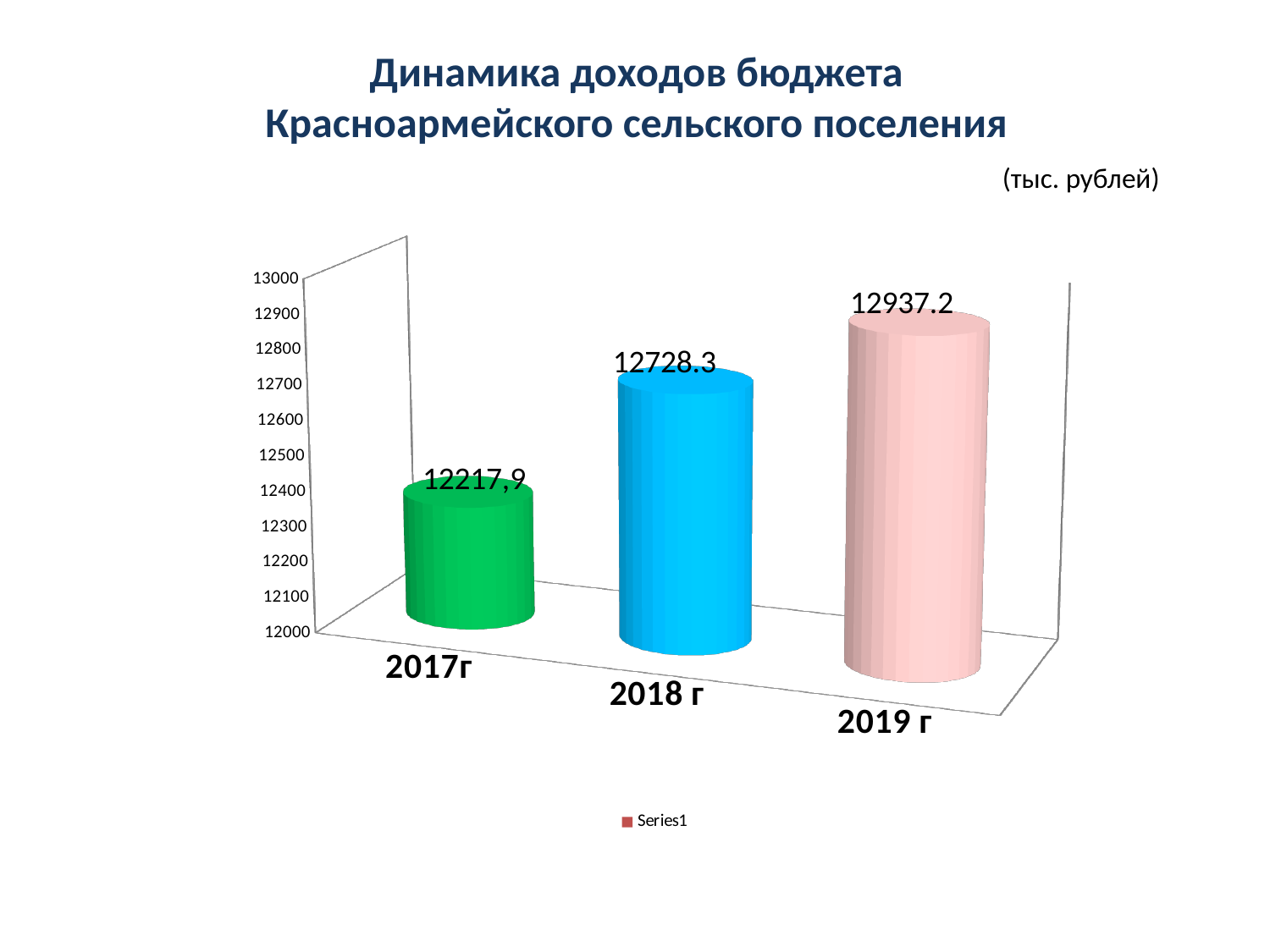
Do the values rise or fall from 2017г to 2019 г? Rise What is the value for 2017г? 12217,9 Which year has the highest value? 2019 г How many series does the legend list? 1 How many years are shown on the chart? 3 What kind of chart is shown on the slide? Bar chart Which year has the lowest value? 2017г What is the value for 2019 г? 12937.2 What is the value for 2018 г? 12728.3 What is the difference between the values for 2019 г and 2018 г? 208.9 Which is larger, the value for 2018 г or the value for 2017г? 2018 г